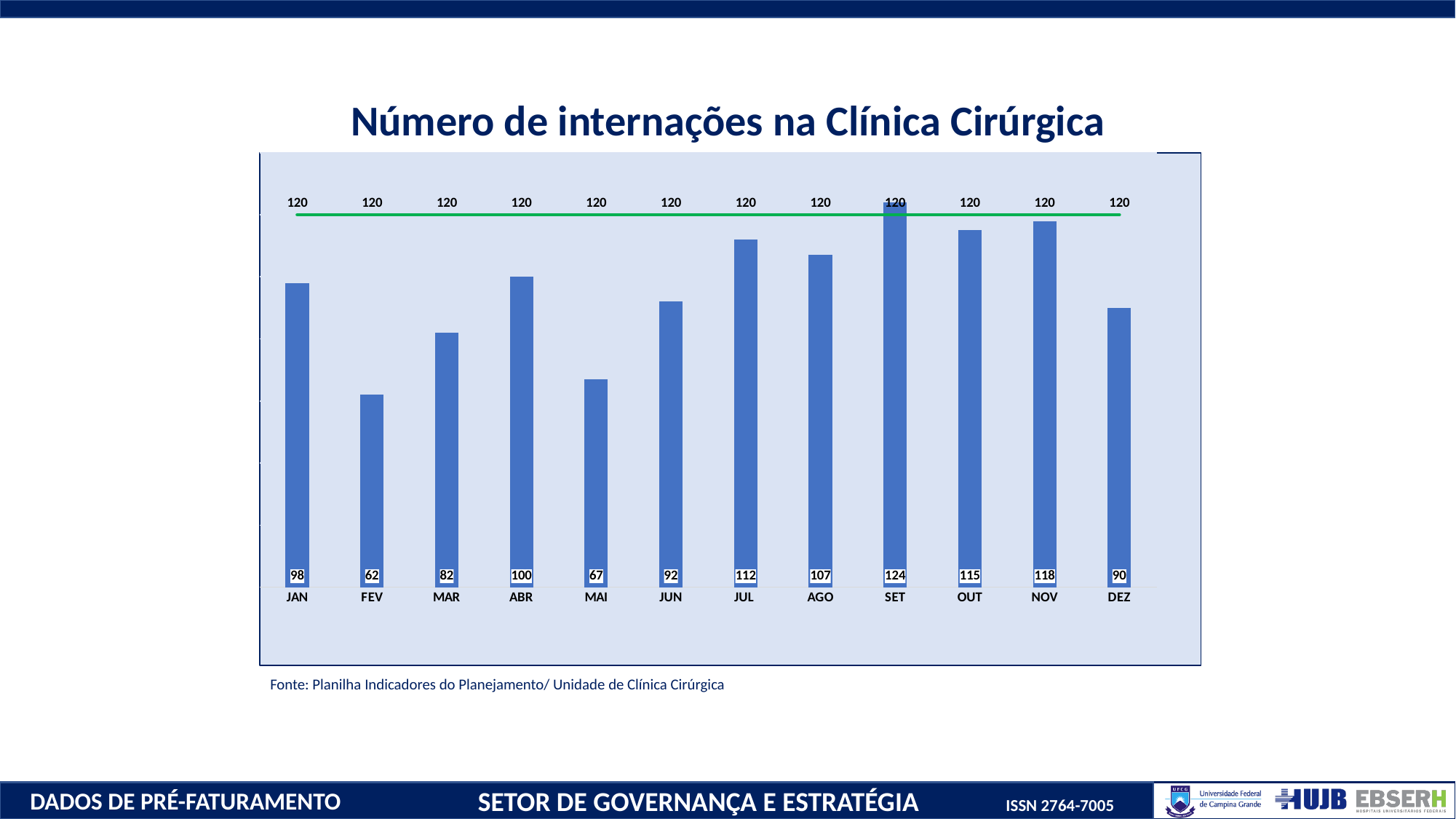
How many months are shown on the x axis? 12 What is the value shown for MAI? 67 What is the title of the chart? Número de internações na Clínica Cirúrgica What is the number of internações for JAN? 98 What is the value of the green reference line shown for each month? 120 Which is the only month whose bar exceeds the green 120 line? SET Which month has the highest number of internações? SET Which month has the lowest number of internações? FEV What kind of chart is shown on the slide? Bar chart What is the value shown for SET? 124 What is the difference between the values for NOV and DEZ? 28 Which is larger, the value for JUL or the value for AGO? JUL